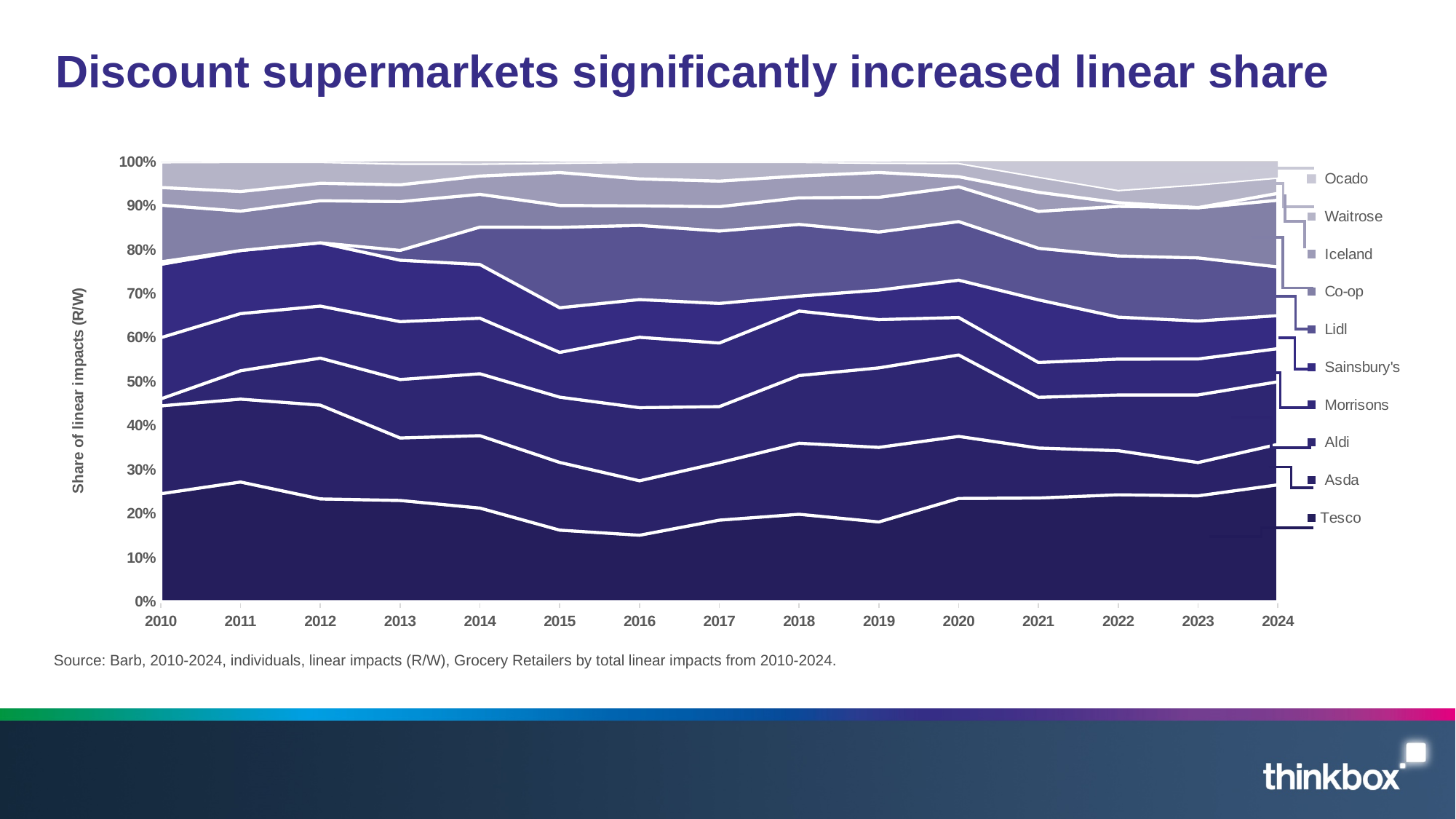
Does Tesco's share of linear impacts rise or fall between 2016 and 2024? Rise What kind of chart is shown on the slide? Stacked area chart Is Tesco's share of linear impacts in 2010 greater or less than 20%? greater Which series is the first year, 2010, or the last year, 2024, larger for Tesco's share of linear impacts? 2024 What is the title of the slide? Discount supermarkets significantly increased linear share How many series does the legend list? 10 How many years are shown along the x axis? 15 Is Tesco's share of linear impacts in 2016 greater or less than 20%? less Which is larger, Tesco's share of linear impacts in 2011 or in 2019? 2011 Does Tesco's share of linear impacts rise or fall between 2011 and 2016? Fall What is the label on the y axis? Share of linear impacts (R/W) Is Tesco's share of linear impacts in 2024 greater or less than 20%? greater